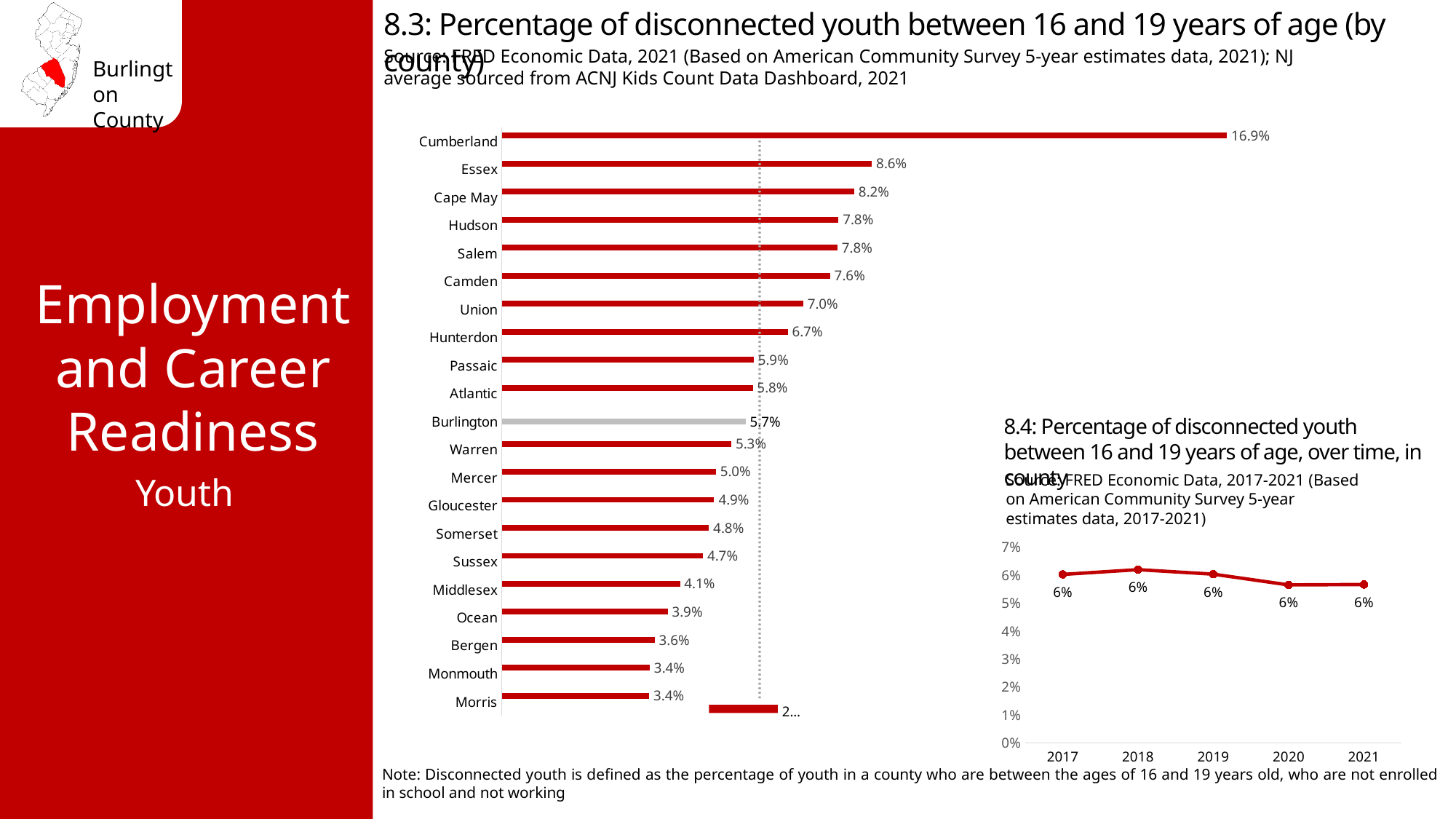
In the 8.3 chart (by county), which is larger, the value for Camden or the value for Union? Camden In the 8.3 chart (by county), how many counties are shown? 21 In the 8.4 chart (over time), how many years are plotted? 5 What kind of chart is the 8.4 chart (over time)? Line chart In the 8.4 chart (over time), what is the value for 2019? 6% In the 8.3 chart (by county), what is the value for Middlesex? 4.1% In the 8.3 chart (by county), what is the percentage of disconnected youth for Cumberland? 16.9% In the 8.3 chart (by county), what is the difference between Essex and Cape May? 0.4% In the 8.3 chart (by county), which county has the highest percentage of disconnected youth? Cumberland In the 8.3 chart (by county), what is the value for Burlington? 5.7% What kind of chart is the 8.3 chart (by county)? Bar chart In the 8.3 chart (by county), what is the difference between Cumberland and Burlington? 11.2%